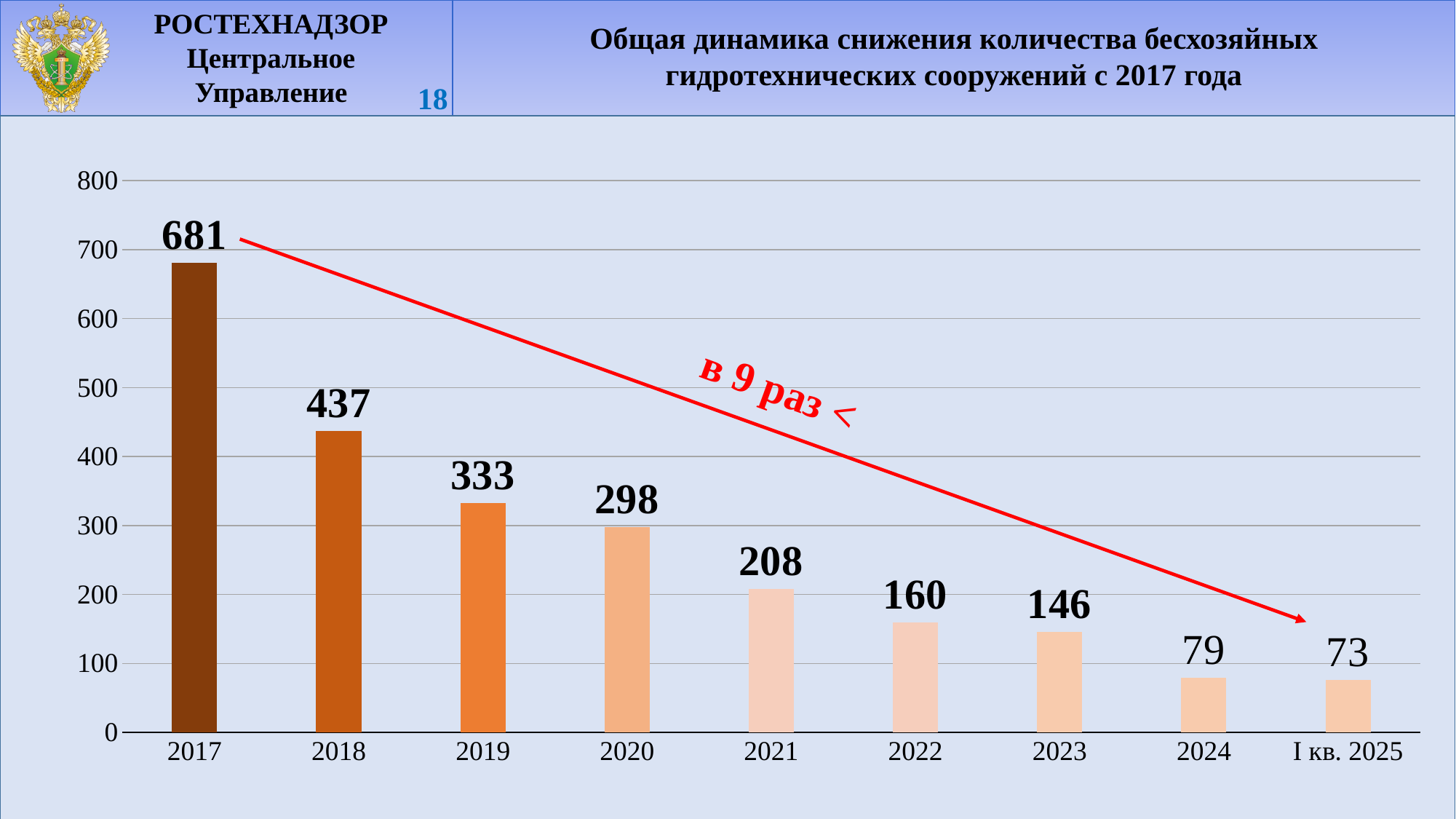
What does the red annotation along the arrow say? в 9 раз < What is the value for I кв. 2025? 73 Do the values rise or fall from 2017 to I кв. 2025? fall What is the value for 2021? 208 What is the difference between the values for 2022 and 2023? 14 What is the difference between the values for 2017 and 2018? 244 What kind of chart is shown on the slide? bar chart Which year has the highest value? 2017 What is the value for 2017? 681 Which category has the lowest value? I кв. 2025 Which is larger, the value for 2019 or the value for 2020? 2019 How many categories are shown on the x axis? 9